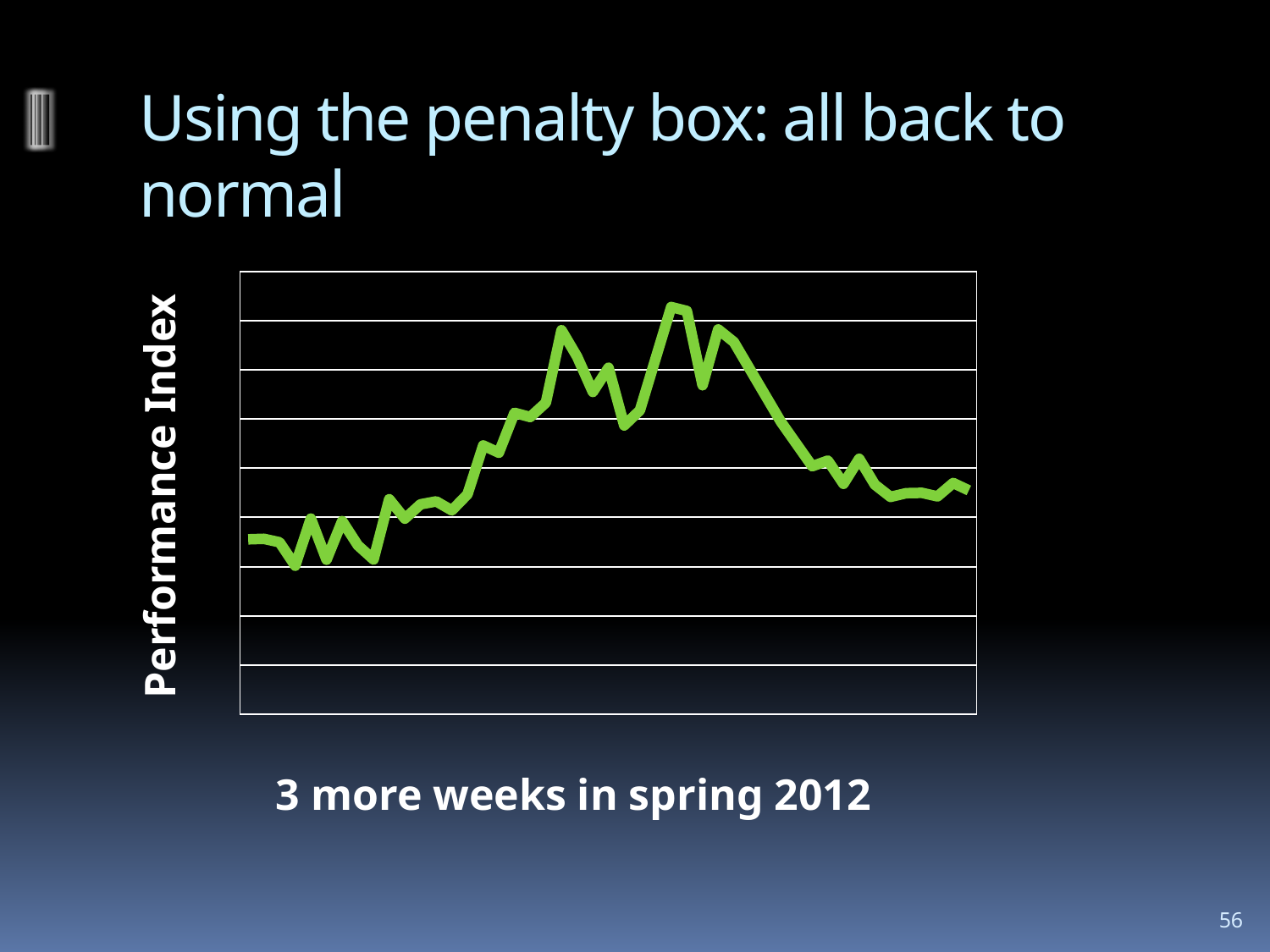
What caption appears below the chart describing the time period? 3 more weeks in spring 2012 How many lines (data series) are plotted on the chart? 1 After reaching its peak, does the line rise or fall toward the right end of the chart? fall Does the line rise or fall from its start to its peak in the middle of the chart? rise Is the value at the right end of the line higher or lower than the value at the left end? higher What kind of chart is shown on the slide? line chart What is the label on the vertical axis of the chart? Performance Index Is the lowest point of the line in the left half or the right half of the chart? left half